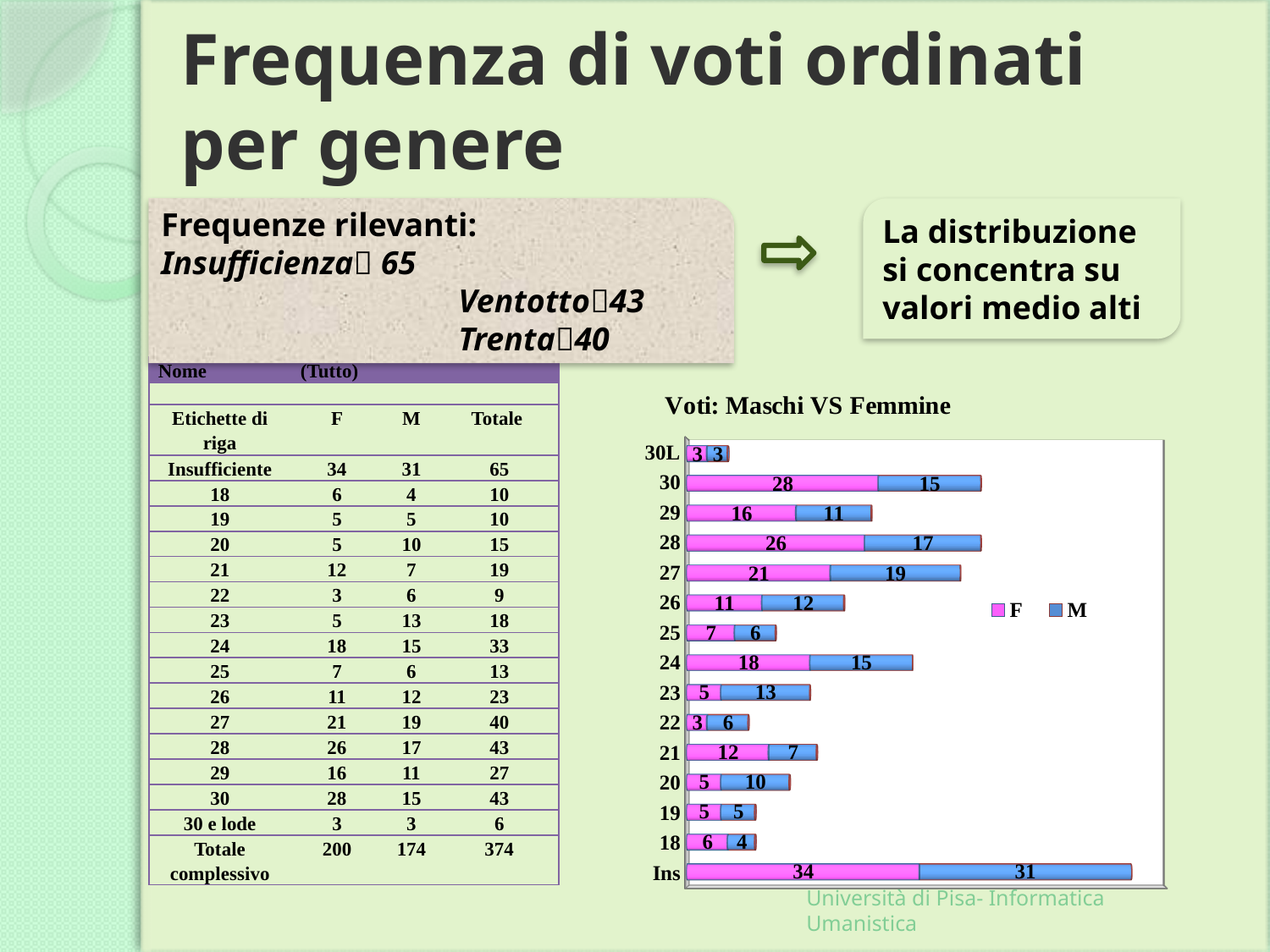
In the chart, is the F value for category 24 larger or the M value for category 24? F What is the difference between the F and M values for category 29 in the chart? 5 What is the M value for the Ins category in the chart? 31 Which category has the lowest M value in the chart? 30L How many categories are shown on the chart's vertical axis? 15 What is the title of the chart on the slide? Voti: Maschi VS Femmine Which category has the highest F value in the chart? Ins What is the M value for category 27 in the chart? 19 What kind of chart is shown on the slide? stacked bar chart What is the F value for category 30 in the chart? 28 What is the total of the stacked bar for category 28 in the chart? 43 How many series does the chart legend list? 2